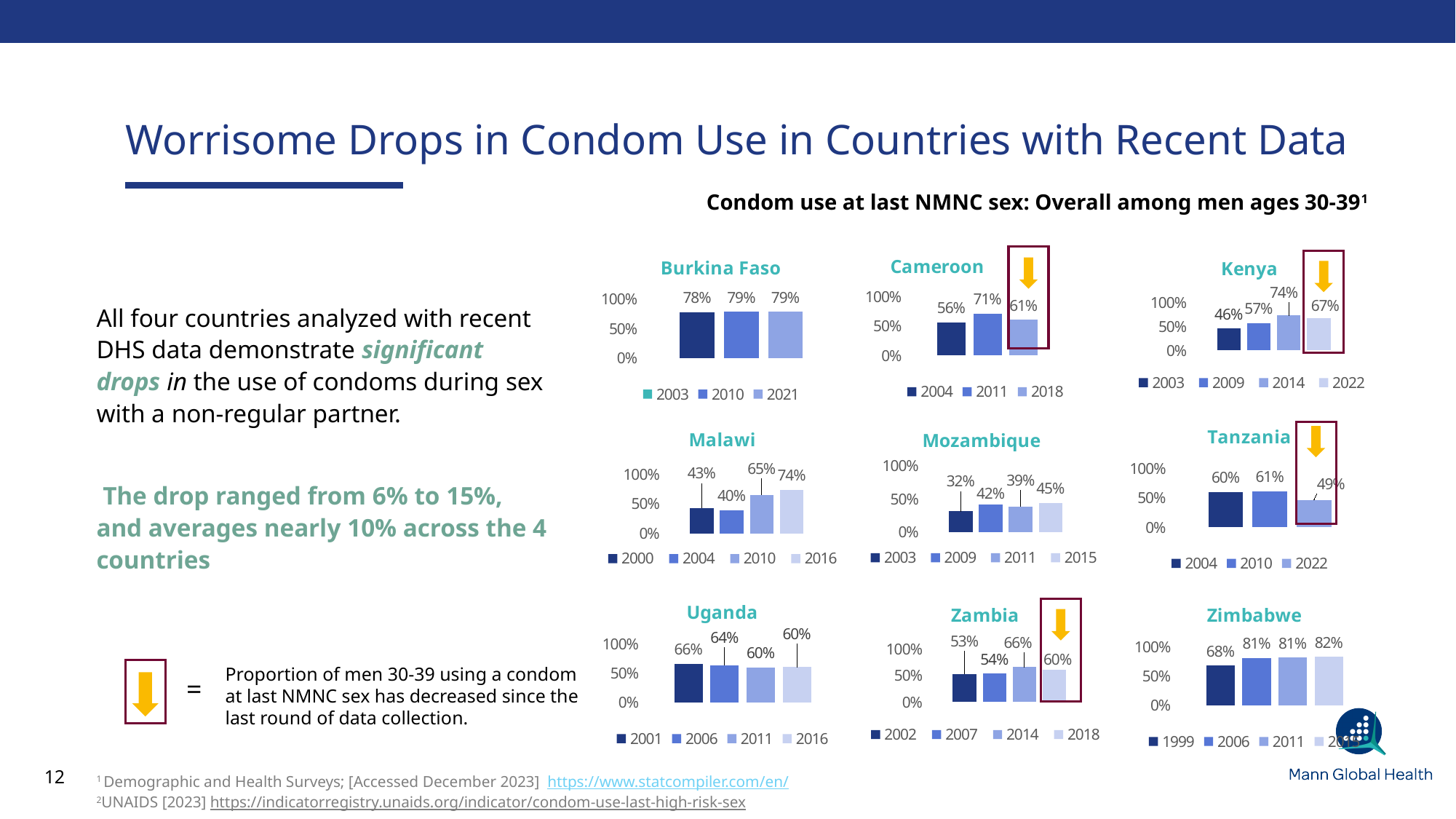
In the Tanzania chart, what is the value for 2022? 49% How many bars are in the Uganda chart? 4 In the Cameroon chart, what is the value for 2018? 61% In the Cameroon chart, what is the difference between the 2011 and 2018 values? 10% In the Kenya chart, what is the difference between the 2014 and 2022 values? 7% In the Uganda chart, do the values rise or fall from 2001 to 2016? fall In the Zambia chart, which is larger, the value for 2014 or the value for 2018? 2014 In the Kenya chart, what is the value for 2014? 74% In the Mozambique chart, which year has the lowest value? 2003 What kind of chart is the Zimbabwe chart? bar chart How many entries does the legend of the Burkina Faso chart list? 3 In the Malawi chart, which year has the highest value? 2016